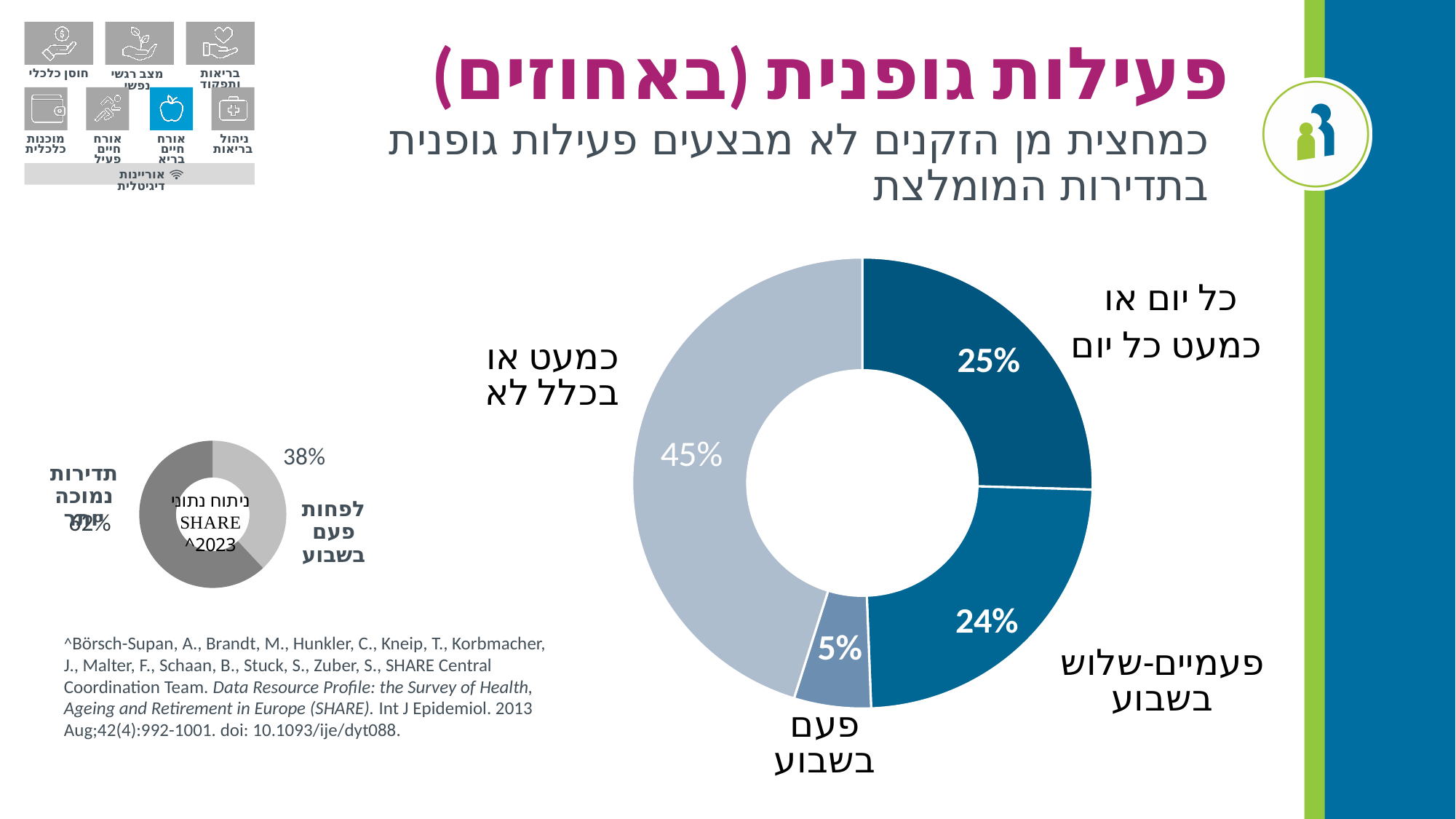
In the large donut chart, which category has the largest share? כמעט או בכלל לא In the large donut chart, what is the difference between the share for 'כמעט או בכלל לא' and the share for 'כל יום או כמעט כל יום'? 20% In the small donut chart on the left, what percentage is shown for 'לפחות פעם בשבוע'? 38% In the large donut chart, what percentage of older adults are physically active every day or almost every day (כל יום או כמעט כל יום)? 25% In the small donut chart on the left, what percentage is shown for 'תדירות נמוכה יותר'? 62% In the large donut chart, what percentage are active once a week (פעם בשבוע)? 5% In the large donut chart, what percentage are almost never or never active (כמעט או בכלל לא)? 45% In the large donut chart, what percentage are active two to three times a week (פעמיים-שלוש בשבוע)? 24% In the large donut chart, which category has the smallest share? פעם בשבוע How many categories does the large donut chart show? 4 What type of chart is the large chart on the right side of the slide? Donut (pie) chart In the large donut chart, which is larger: the share for 'פעמיים-שלוש בשבוע' or the share for 'פעם בשבוע'? פעמיים-שלוש בשבוע